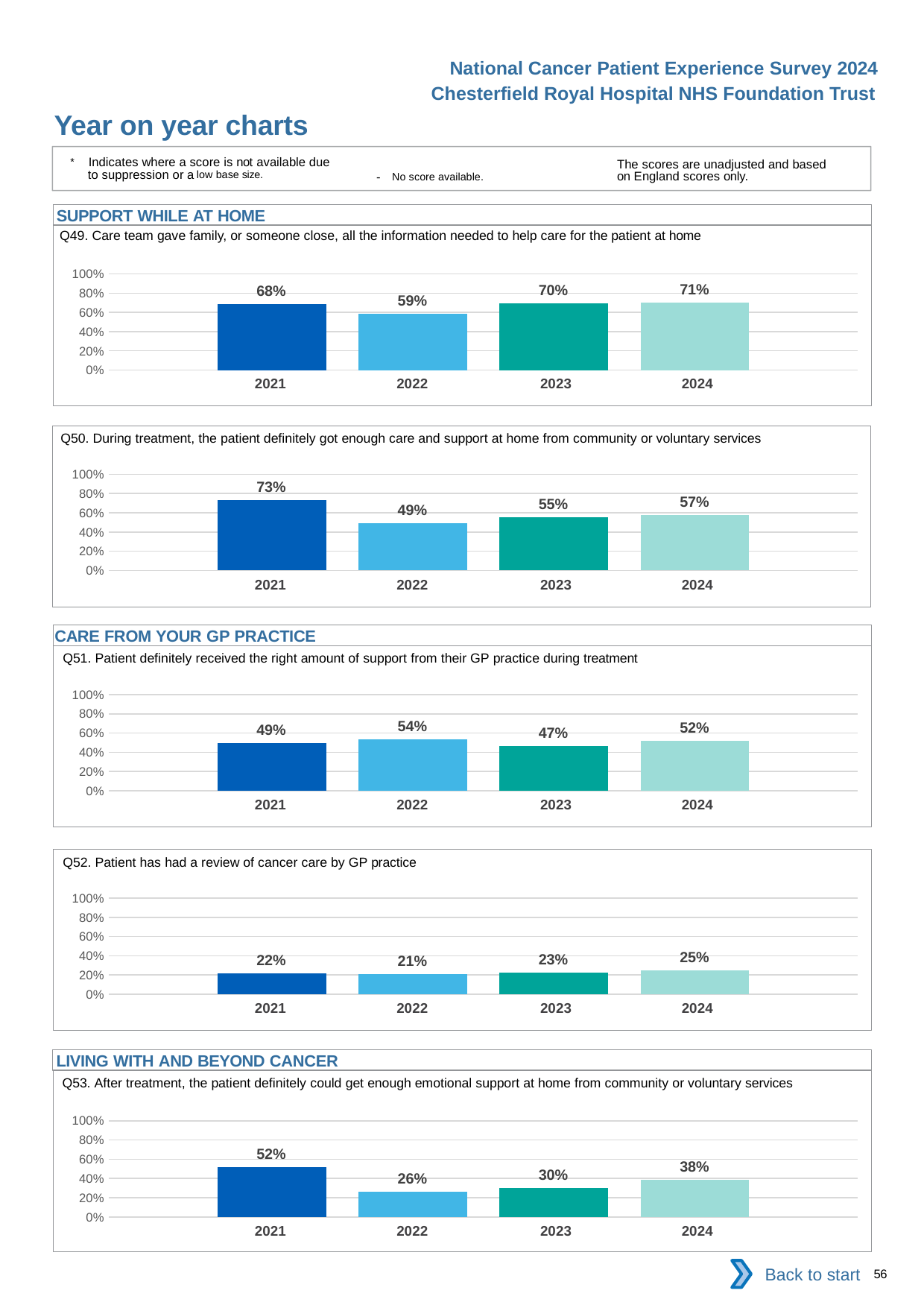
In the Q50 chart, what is the difference between the 2021 and 2022 values? 24 percentage points In the Q49 chart, which year has the lowest value? 2022 How many years are shown in the Q50 chart? 4 In the Q53 chart, what is the difference between the 2024 and 2023 values? 8 percentage points In the Q51 chart, what is the value for 2023? 47% In the Q52 chart, is the value for 2024 greater or less than 40%? less In the Q53 chart, what is the value for 2021? 52% In the Q52 chart, do the values rise or fall from 2022 to 2024? rise In the Q51 chart, which is larger, the value for 2022 or the value for 2024? 2022 In the Q50 chart, which year has the highest value? 2021 In the Q49 chart, what is the value for 2024? 71% What kind of chart is the Q49 chart? bar chart